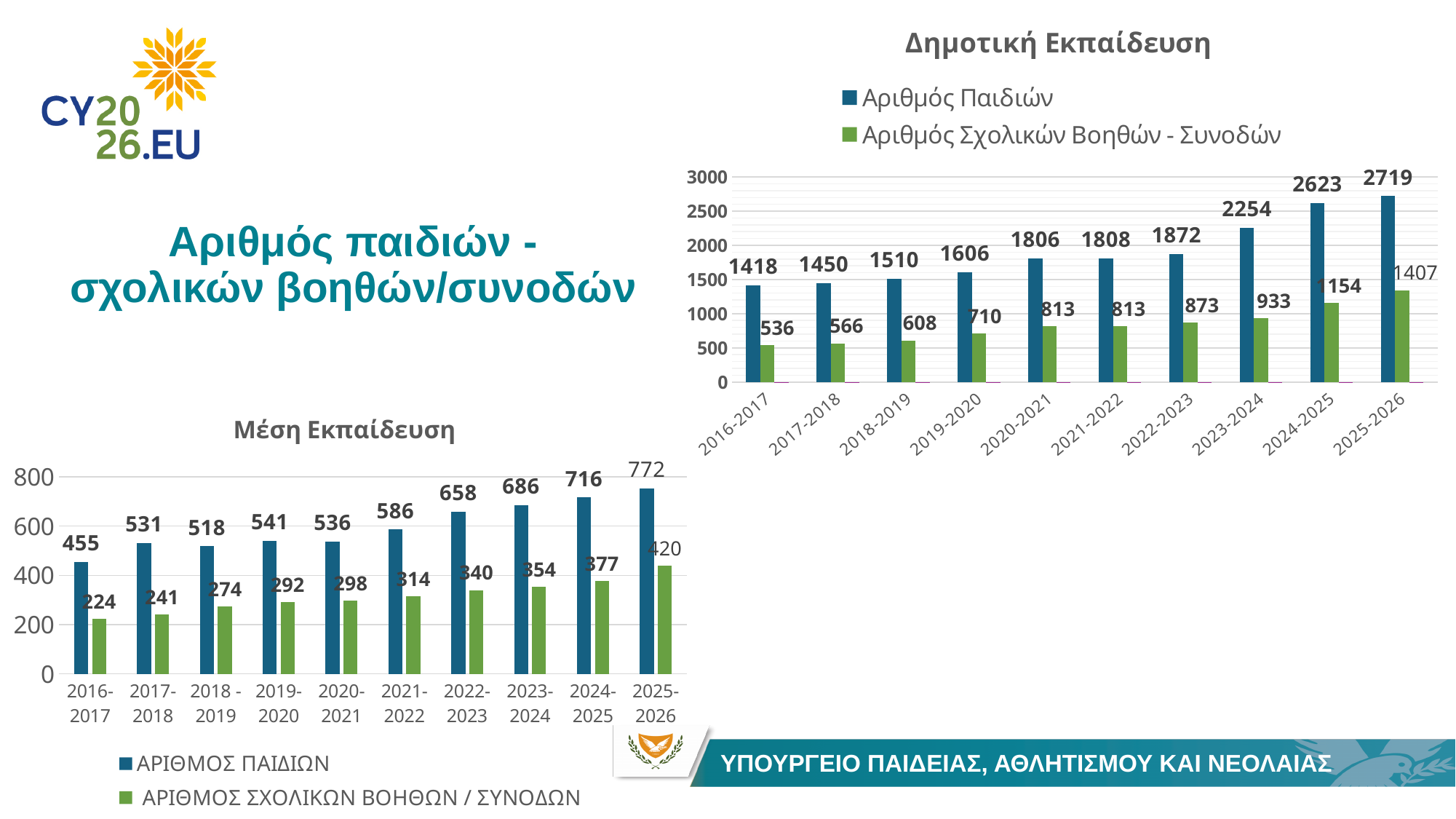
In the 'Μέση Εκπαίδευση' chart, how many school years are shown on the x axis? 10 In the 'Μέση Εκπαίδευση' chart, which year has the highest value for 'ΑΡΙΘΜΟΣ ΠΑΙΔΙΩΝ'? 2025-2026 In the 'Δημοτική Εκπαίδευση' chart, how many series does the legend list? 2 What type of chart is the 'Μέση Εκπαίδευση' chart? bar chart In the 'Δημοτική Εκπαίδευση' chart, do the values for 'Αριθμός Σχολικών Βοηθών - Συνοδών' rise or fall from 2016-2017 to 2025-2026? rise In the 'Δημοτική Εκπαίδευση' chart, what is the value of 'Αριθμός Σχολικών Βοηθών - Συνοδών' for 2019-2020? 710 In the 'Μέση Εκπαίδευση' chart, what is the value of 'ΑΡΙΘΜΟΣ ΣΧΟΛΙΚΩΝ ΒΟΗΘΩΝ / ΣΥΝΟΔΩΝ' for 2025-2026? 420 In the 'Μέση Εκπαίδευση' chart, which is larger: 'ΑΡΙΘΜΟΣ ΠΑΙΔΙΩΝ' in 2017-2018 or in 2018-2019? 2017-2018 In the 'Δημοτική Εκπαίδευση' chart, which year has the lowest value for 'Αριθμός Παιδιών'? 2016-2017 In the 'Δημοτική Εκπαίδευση' chart, what is the value of 'Αριθμός Παιδιών' for 2025-2026? 2719 In the 'Μέση Εκπαίδευση' chart, what is the value of 'ΑΡΙΘΜΟΣ ΠΑΙΔΙΩΝ' for 2021-2022? 586 In the 'Δημοτική Εκπαίδευση' chart, what is the difference between 'Αριθμός Παιδιών' in 2024-2025 and 2023-2024? 369